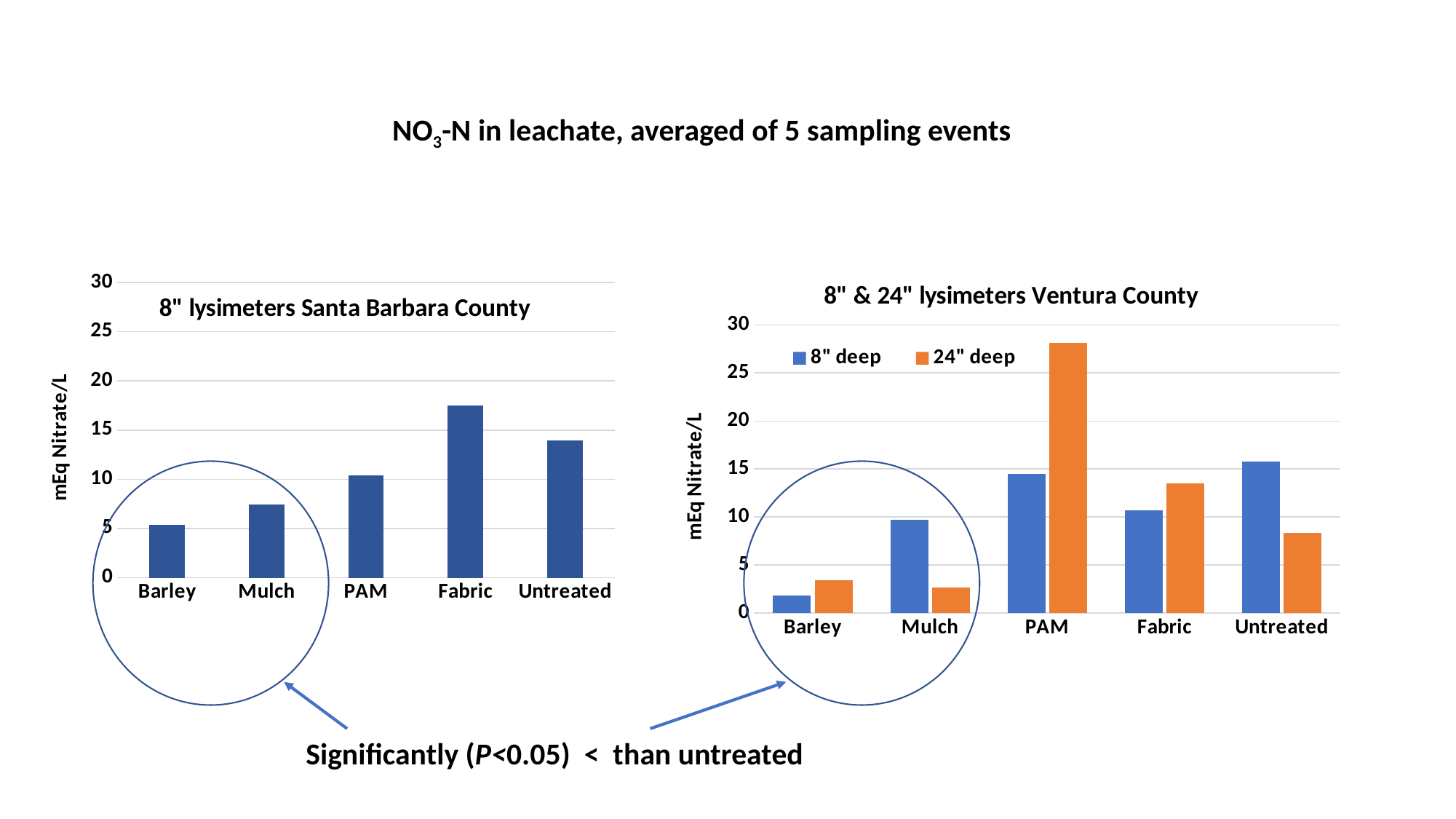
In the chart titled "8" & 24" lysimeters Ventura County", which category has the lowest 8" deep value? Barley What is the y-axis label of the chart titled "8" & 24" lysimeters Ventura County"? mEq Nitrate/L In the chart titled "8" lysimeters Santa Barbara County", is the value for Fabric greater or less than 15? greater In the chart titled "8" & 24" lysimeters Ventura County", how many series does the legend list? 2 In the chart titled "8" lysimeters Santa Barbara County", which category has the lowest value? Barley In the chart titled "8" lysimeters Santa Barbara County", is the value for Barley greater or less than 10? less In the chart titled "8" & 24" lysimeters Ventura County", which is larger for Untreated: the 8" deep value or the 24" deep value? 8" deep What kind of chart is the one titled "8" lysimeters Santa Barbara County"? bar chart In the chart titled "8" & 24" lysimeters Ventura County", is the 24" deep value for PAM greater or less than 25? greater In the chart titled "8" lysimeters Santa Barbara County", which category has the highest value? Fabric In the chart titled "8" lysimeters Santa Barbara County", how many categories are shown on the x axis? 5 In the chart titled "8" & 24" lysimeters Ventura County", which category has the highest 24" deep value? PAM